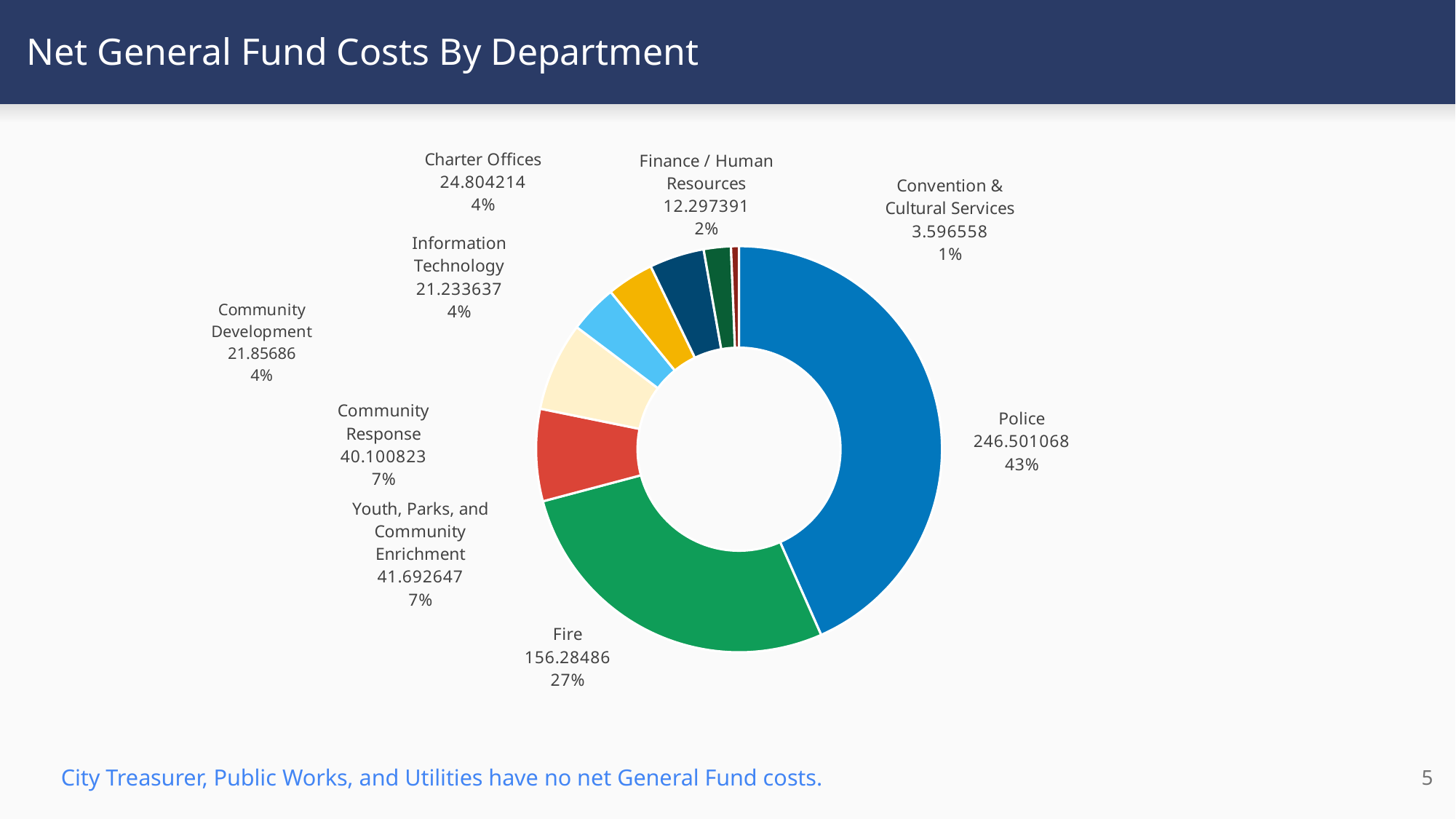
Which department has the smallest net General Fund cost? Convention & Cultural Services What kind of chart is shown on the slide? doughnut chart What percentage share does Fire have? 27% Which is larger, the value for Charter Offices or the value for Information Technology? Charter Offices What is the difference between the Police value and the Fire value? 90.216208 What is the value shown for Finance / Human Resources? 12.297391 What is the title of the slide containing the chart? Net General Fund Costs By Department What is the value shown for Police? 246.501068 How many departments are shown in the chart? 9 Which department has the largest net General Fund cost? Police What percentage share does Police have? 43% What is the value shown for Fire? 156.28486